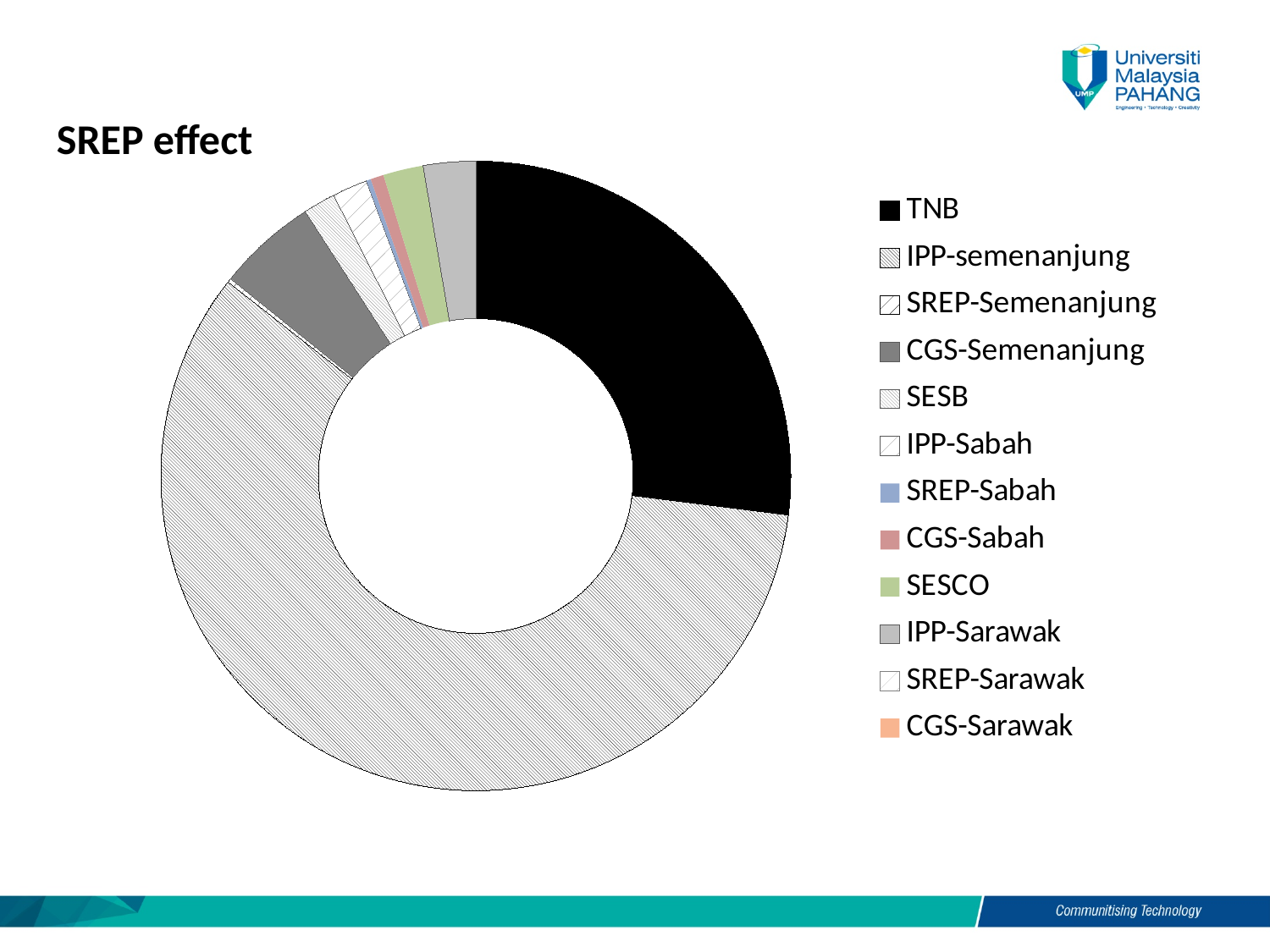
What kind of chart is shown on the slide? Doughnut chart How many categories does the legend of the chart list? 12 What is the title shown above the chart? SREP effect Which category has the largest slice in the chart? IPP-semenanjung Which category is shown in solid black in the chart? TNB Which slice is larger, TNB or CGS-Semenanjung? TNB Which slice is larger, IPP-semenanjung or CGS-Semenanjung? IPP-semenanjung Which slice is larger, CGS-Semenanjung or SESCO? CGS-Semenanjung